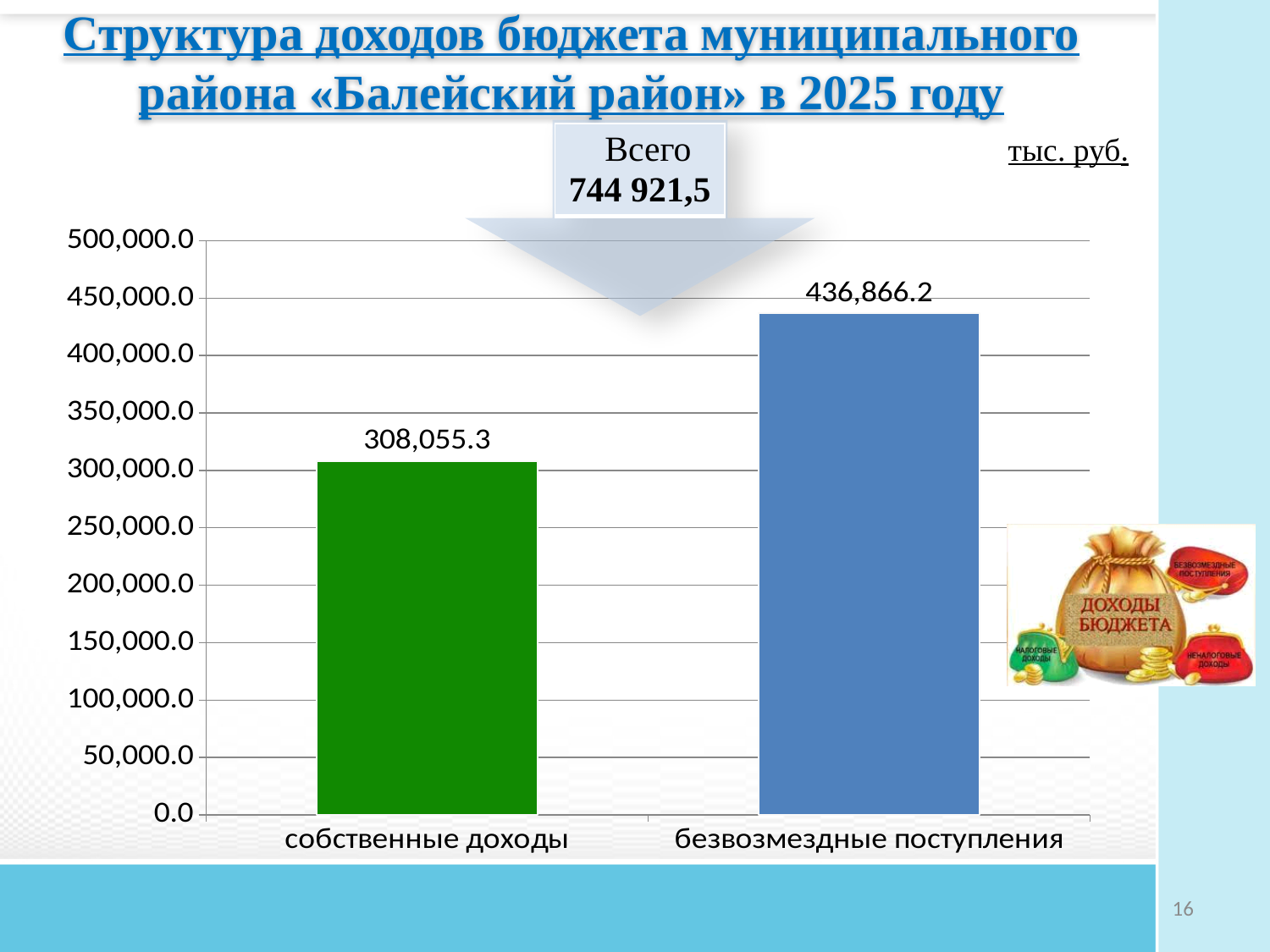
What is the value for собственные доходы? 308,055.3 What total (Всего) is shown above the chart? 744 921,5 What is the value for безвозмездные поступления? 436,866.2 Is the value for собственные доходы greater or less than 350,000.0? less How many categories are shown on the chart? 2 Which category has the highest value? безвозмездные поступления What is the difference between безвозмездные поступления and собственные доходы? 128,810.9 Which category has the lowest value? собственные доходы Is the value for безвозмездные поступления greater or less than 400,000.0? greater What kind of chart is shown on the slide? bar chart What colour is the bar for собственные доходы? green Which is larger, собственные доходы or безвозмездные поступления? безвозмездные поступления